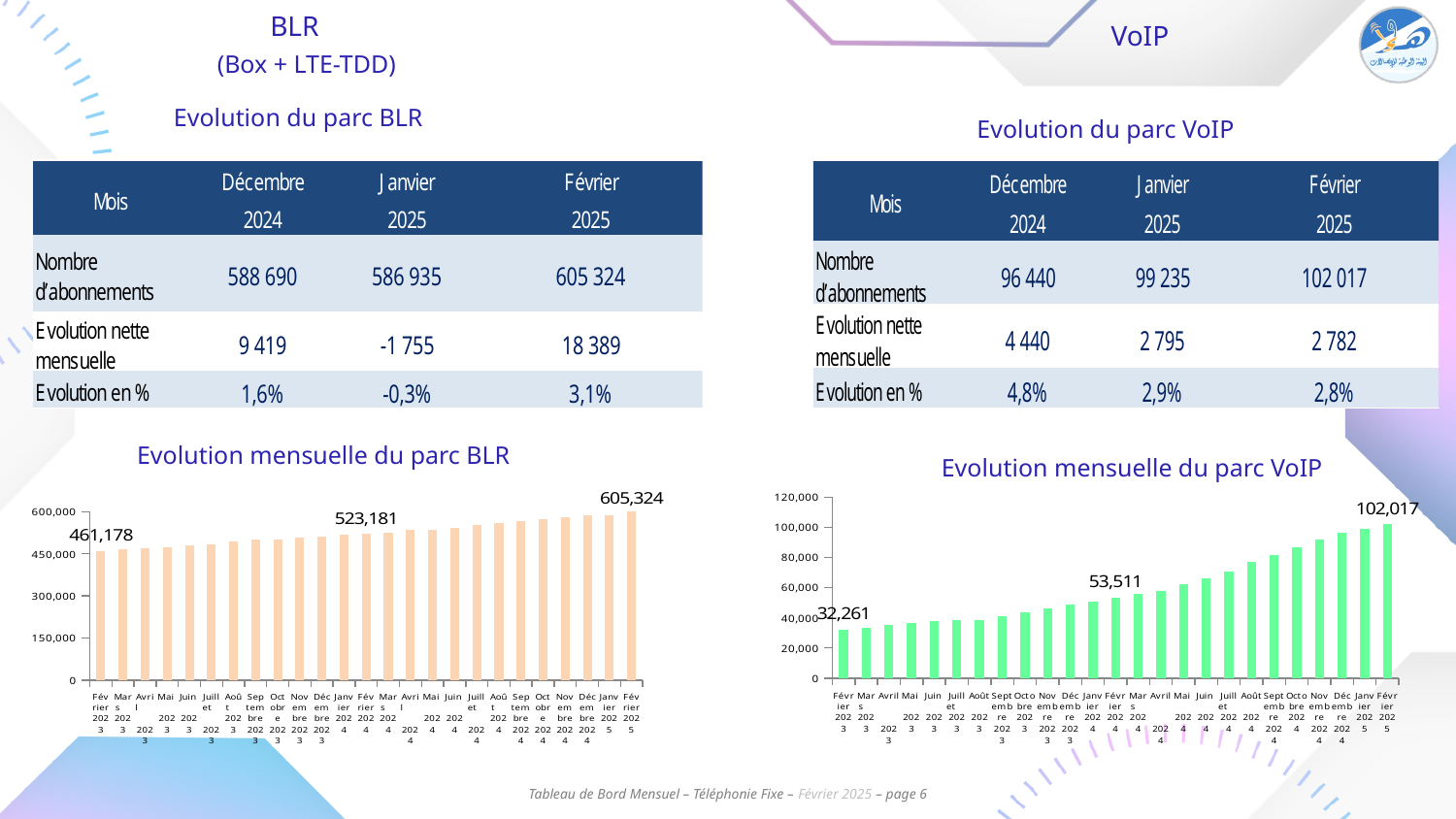
In the "Evolution mensuelle du parc VoIP" chart, which month has the highest value? Février 2025 In the "Evolution mensuelle du parc BLR" chart, what is the difference between the labelled values for Février 2025 and Février 2024? 82,143 How many monthly bars are plotted in the "Evolution mensuelle du parc BLR" chart? 25 In the "Evolution mensuelle du parc BLR" chart, what is the value labelled for Février 2023? 461,178 In the "Evolution mensuelle du parc BLR" chart, what is the value labelled for Février 2025? 605,324 In the "Evolution mensuelle du parc VoIP" chart, is the value for Décembre 2024 greater or less than 80,000? greater In the "Evolution mensuelle du parc VoIP" chart, what is the difference between the labelled values for Février 2025 and Février 2023? 69,756 In the "Evolution mensuelle du parc BLR" chart, which month has the lowest value? Février 2023 In the "Evolution mensuelle du parc BLR" chart, is the value for Décembre 2024 greater or less than 450,000? greater In the "Evolution mensuelle du parc VoIP" chart, do the values generally rise or fall from Février 2023 to Février 2025? rise What kind of chart is "Evolution mensuelle du parc BLR"? bar chart In the "Evolution mensuelle du parc VoIP" chart, what is the value labelled for Février 2024? 53,511